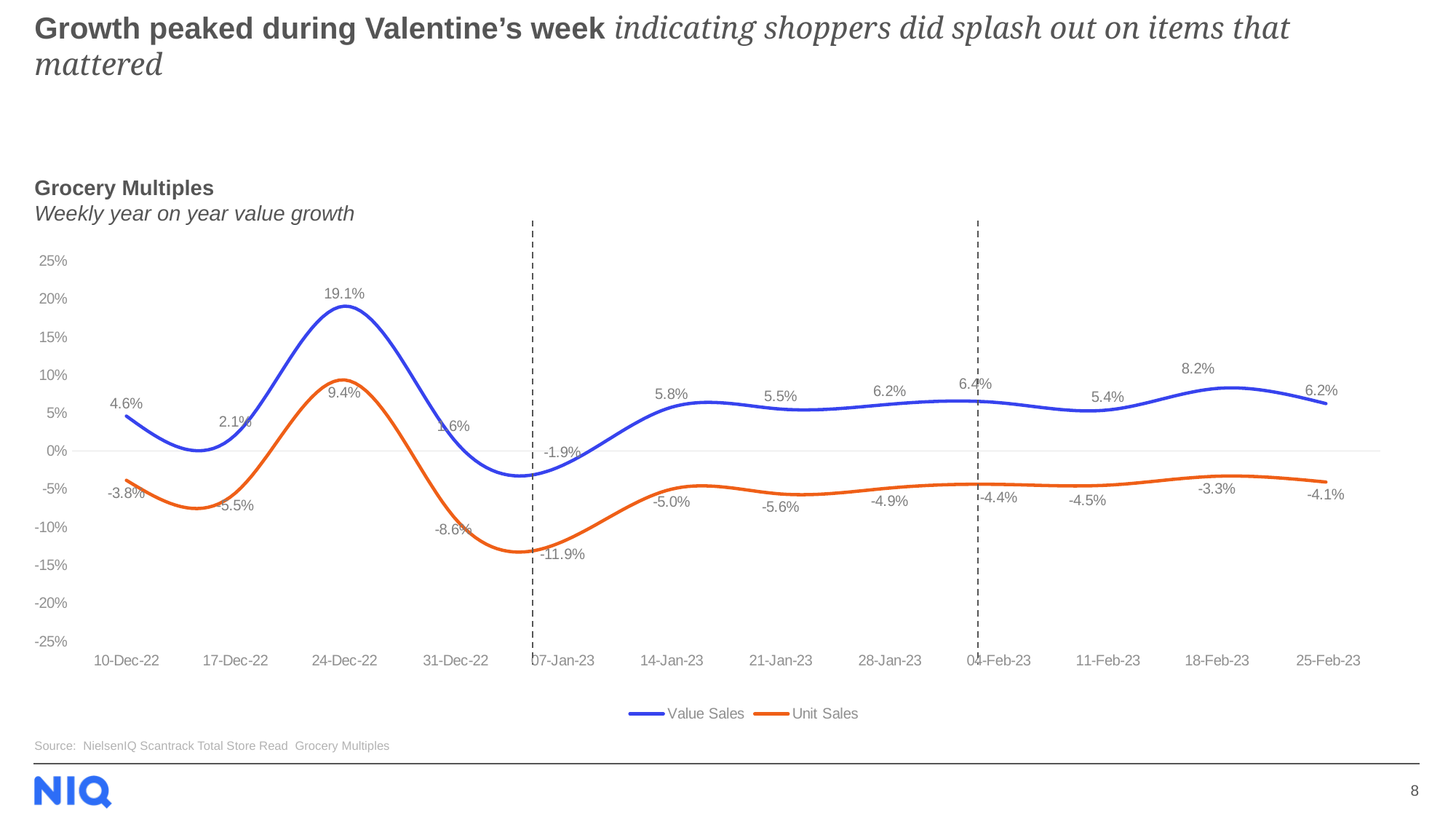
What type of chart is shown on the slide? Line chart How many weeks are plotted on the x axis? 12 In which week is Unit Sales growth at its lowest? 07-Jan-23 Which week has higher Value Sales growth, 18-Feb-23 or 25-Feb-23? 18-Feb-23 What is the Unit Sales growth for the week of 07-Jan-23? -11.9% How many series does the legend list? 2 What is the Unit Sales growth for the week of 18-Feb-23? -3.3% In which week is Value Sales growth at its lowest? 07-Jan-23 In which week does Value Sales growth reach its highest value? 24-Dec-22 By how much did Value Sales growth change from 11-Feb-23 to 18-Feb-23? 2.8 percentage points What is the difference between Value Sales and Unit Sales growth in the week of 24-Dec-22? 9.7 percentage points What is the Value Sales growth for the week of 24-Dec-22? 19.1%